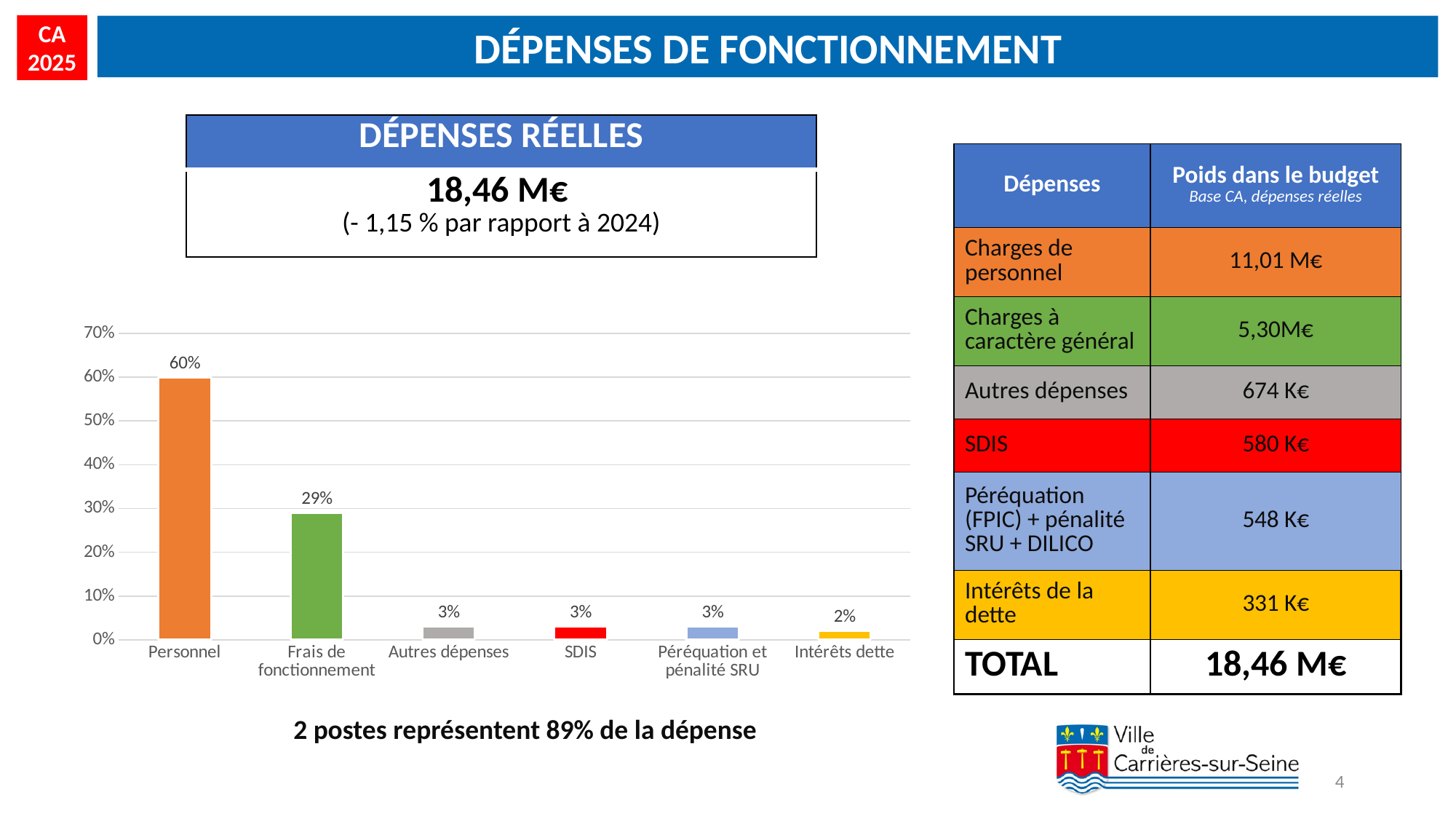
What is the value for Personnel in the bar chart? 60% Which category has the lowest value in the bar chart? Intérêts dette Which is larger, the value for Frais de fonctionnement or the value for Autres dépenses? Frais de fonctionnement What colour is the bar for Personnel? orange Do the values rise or fall from left to right along the x axis of the bar chart? fall What is the value for SDIS in the bar chart? 3% What kind of chart is shown on the slide? bar chart How many categories are shown in the bar chart? 6 What is the difference between the values for Personnel and Frais de fonctionnement? 31% What is the value for Intérêts dette in the bar chart? 2% What is the value for Frais de fonctionnement in the bar chart? 29% Which category has the highest value in the bar chart? Personnel